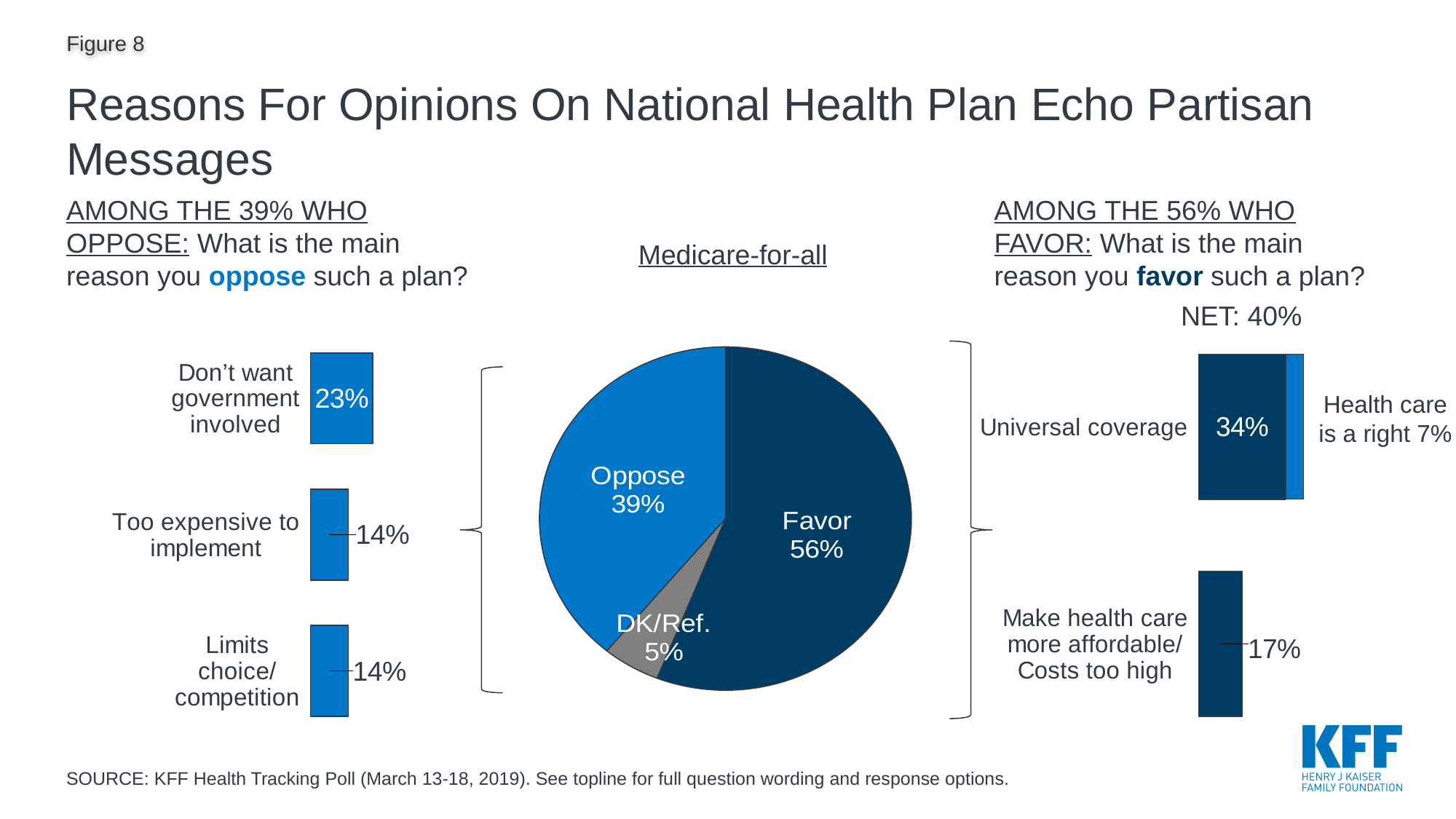
In the left-hand bar chart of reasons for opposing the plan, what is the value for 'Too expensive to implement'? 14% In the Medicare-for-all pie chart, what is the difference between the Favor and Oppose shares? 17 percentage points In the right-hand bar chart of reasons for favoring the plan, what is the value for 'Universal coverage'? 34% In the Medicare-for-all pie chart, what share of respondents oppose the plan? 39% What kind of chart is the center chart titled Medicare-for-all? Pie chart In the left-hand bar chart of reasons for opposing the plan, how many reasons are shown? 3 In the right-hand bar chart of reasons for favoring the plan, what is the difference between 'Universal coverage' and 'Make health care more affordable/Costs too high'? 17 percentage points In the Medicare-for-all pie chart, what share of respondents favor the plan? 56% In the left-hand bar chart of reasons for opposing the plan, what is the value for 'Don't want government involved'? 23% In the Medicare-for-all pie chart, which slice is the smallest? DK/Ref. In the Medicare-for-all pie chart, which slice is the largest? Favor In the Medicare-for-all pie chart, what share is labeled DK/Ref.? 5%